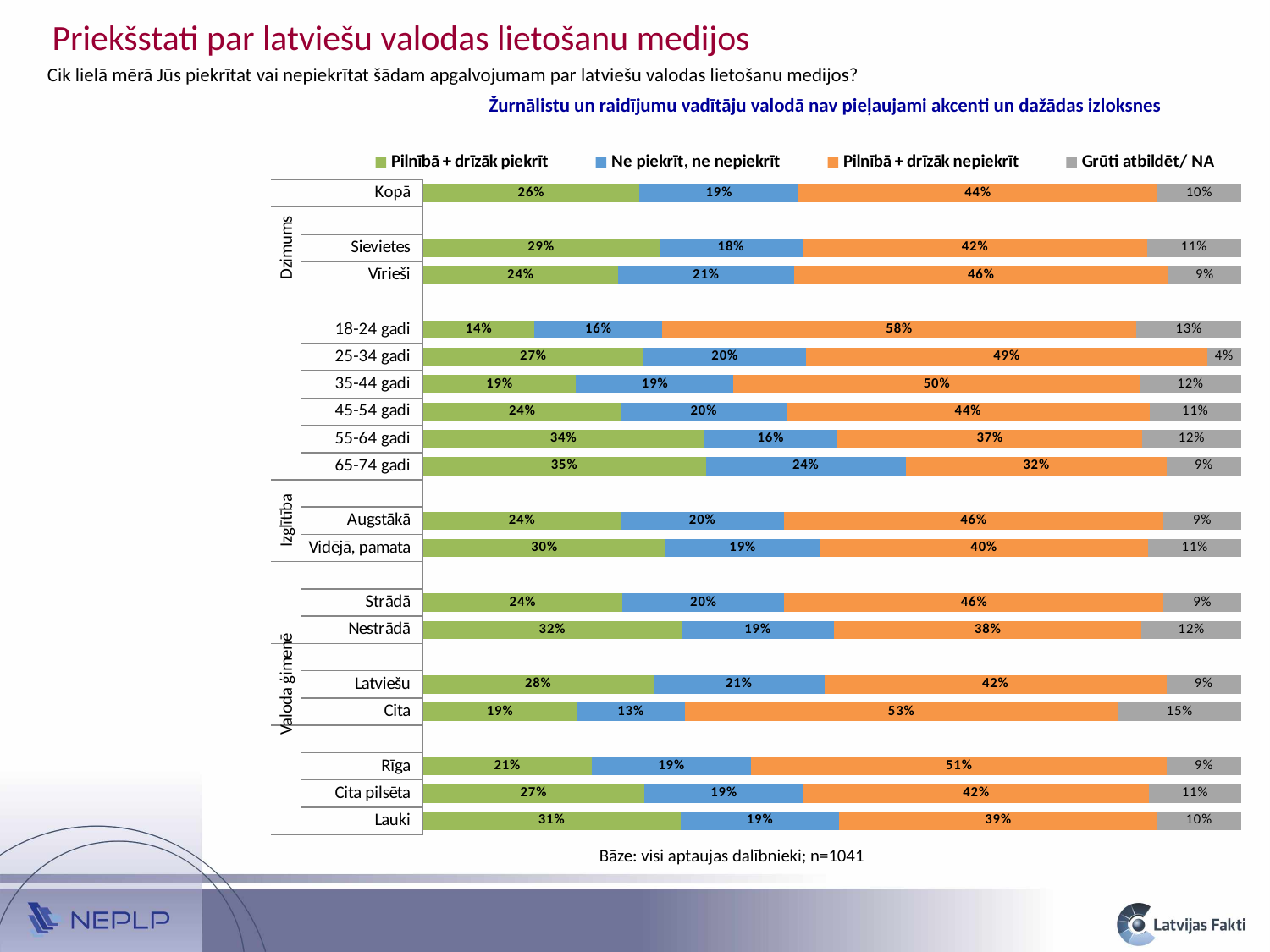
How many series does the legend list? 4 What is the value of "Pilnībā + drīzāk nepiekrīt" for Kopā? 44% What is the value of "Pilnībā + drīzāk piekrīt" for 65-74 gadi? 35% Which category has the lowest value for "Grūti atbildēt/ NA"? 25-34 gadi Which category has the highest value for "Pilnībā + drīzāk nepiekrīt"? 18-24 gadi What kind of chart is shown on the slide? stacked bar chart What is the difference between the "Pilnībā + drīzāk nepiekrīt" values for Rīga and Lauki? 12% What is the value of "Ne piekrīt, ne nepiekrīt" for Latviešu? 21% What is the value of "Grūti atbildēt/ NA" for Cita? 15% How many categories (rows) are plotted in the chart? 18 What is the base (n) stated below the chart? n=1041 Which is larger: the "Pilnībā + drīzāk piekrīt" value for Sievietes or for Vīrieši? Sievietes